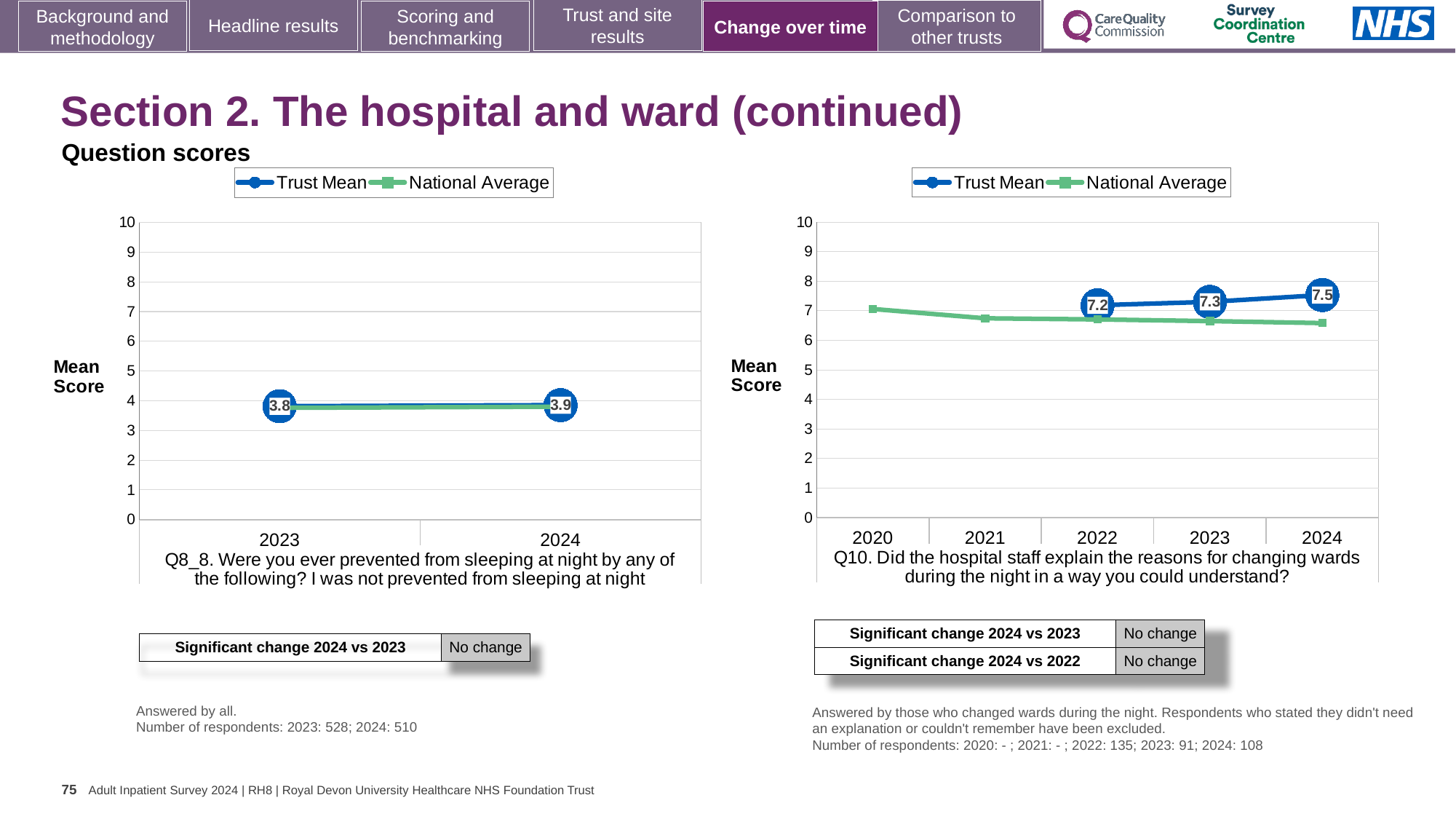
In the right chart (Q10), does the Trust Mean rise or fall from 2022 to 2024? rise In the right chart (Q10), what is the difference between the Trust Mean scores for 2024 and 2022? 0.3 In the left chart (Q8_8), what is the Trust Mean score for 2024? 3.9 How many years are shown on the x axis of the right chart (Q10)? 5 In the left chart (Q8_8), is the Trust Mean value for 2024 greater or less than 5? less In the right chart (Q10), what is the Trust Mean score for 2024? 7.5 In the left chart (Q8_8), what is the Trust Mean score for 2023? 3.8 In the right chart (Q10), which year has the highest Trust Mean score? 2024 How many series does the legend of the right chart (Q10) list? 2 What kind of chart is the left chart (Q8_8)? line chart In the right chart (Q10), is the National Average value for 2024 greater or less than 7? less In the right chart (Q10), what is the Trust Mean score for 2022? 7.2